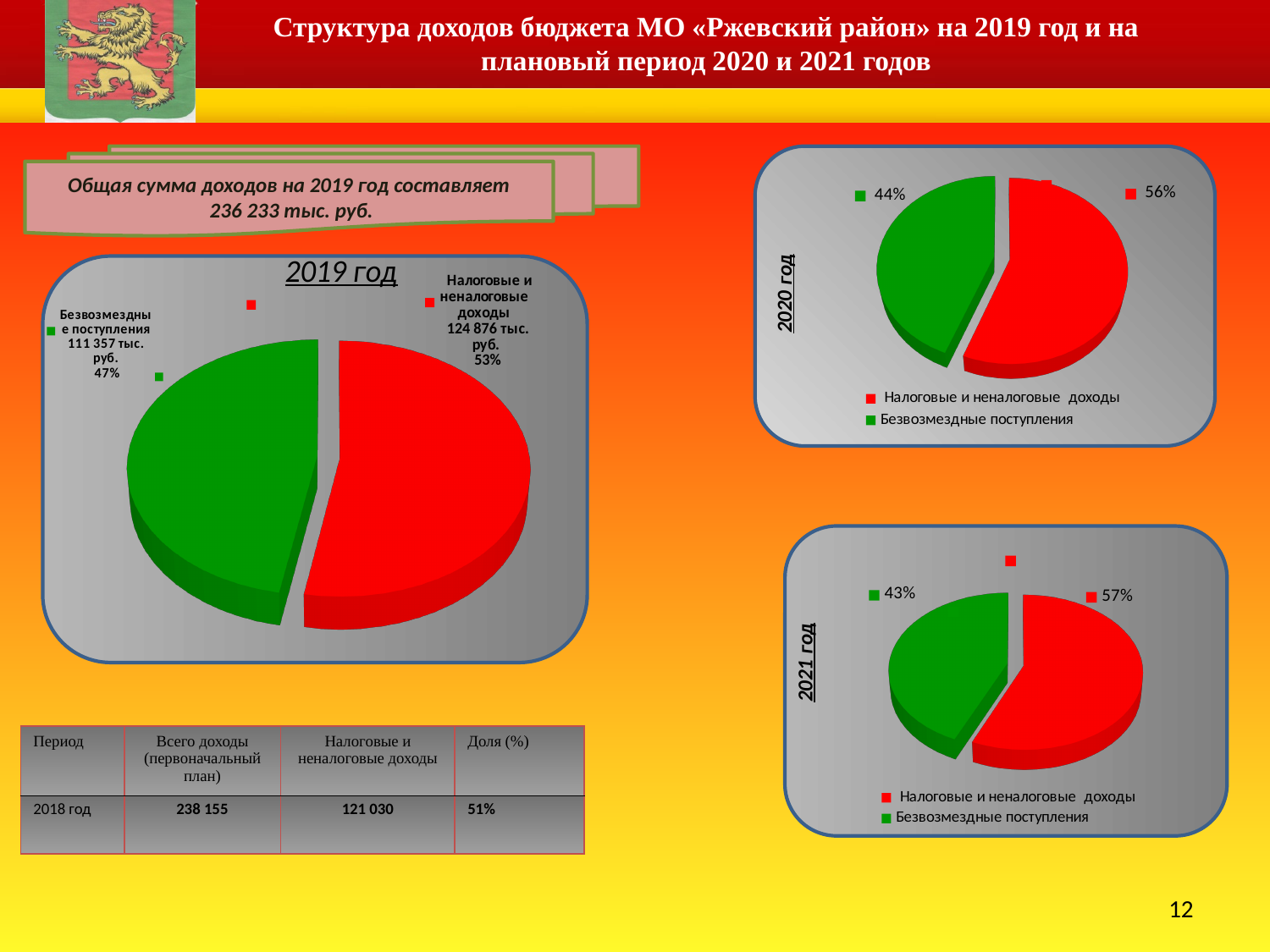
In the 2021 год pie chart, what share do Налоговые и неналоговые доходы have? 57% In the 2021 год pie chart, what share do Безвозмездные поступления have? 43% What type of chart is used for the 2021 год chart? Pie chart In the 2020 год pie chart, what share do Налоговые и неналоговые доходы have? 56% In the 2019 год pie chart, what is the value shown for Безвозмездные поступления in тыс. руб.? 111 357 тыс. руб. How many entries does the legend of the 2020 год chart list? 2 In the 2019 год pie chart, what is the difference in тыс. руб. between Налоговые и неналоговые доходы and Безвозмездные поступления? 13 519 тыс. руб. In the 2019 год pie chart, what is the value shown for Налоговые и неналоговые доходы in тыс. руб.? 124 876 тыс. руб. In the 2019 год pie chart, which slice is larger: Налоговые и неналоговые доходы or Безвозмездные поступления? Налоговые и неналоговые доходы